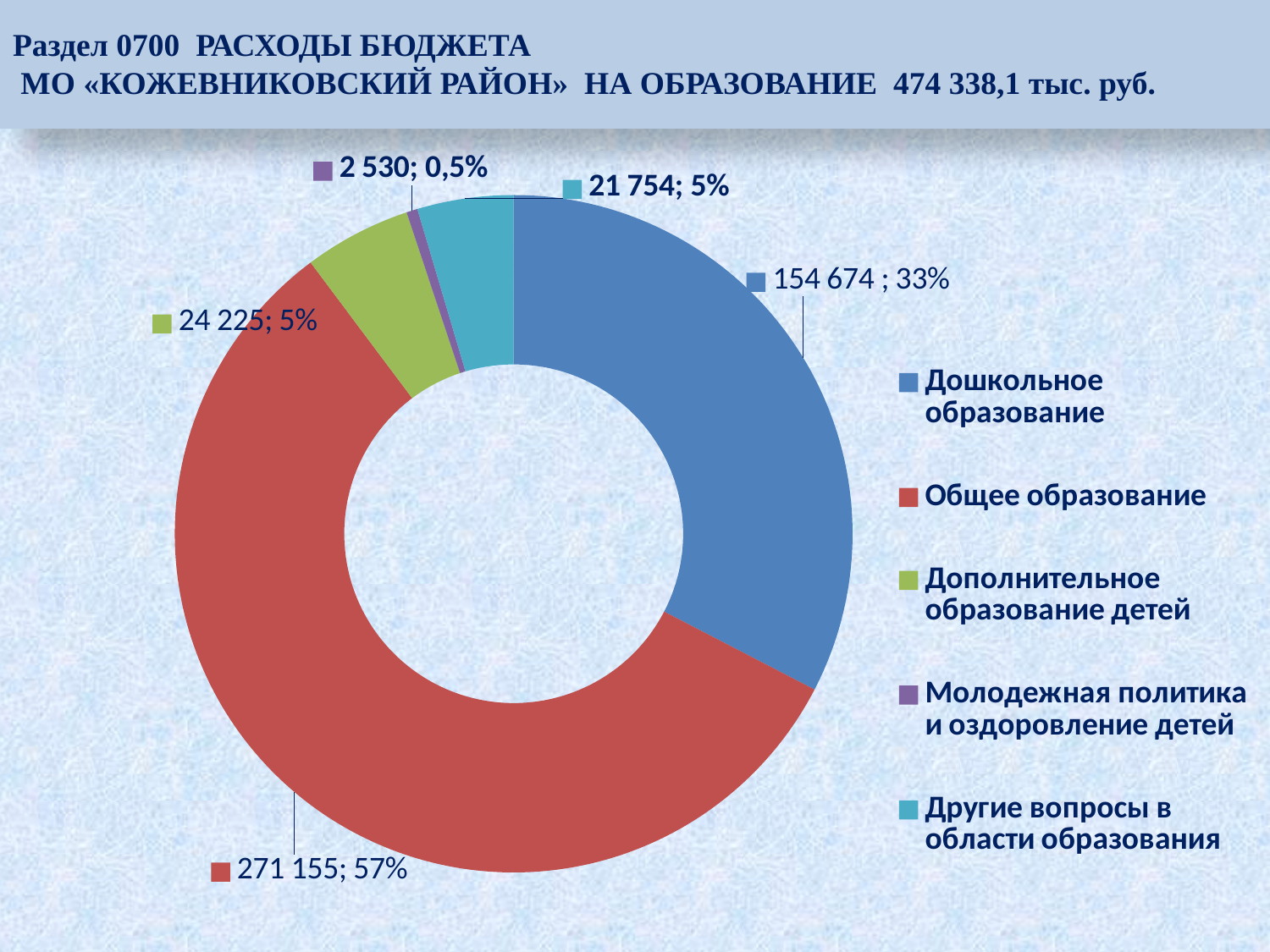
How many categories does the legend list? 5 What is the value for Общее образование? 271 155 What is the value for Другие вопросы в области образования? 21 754 What is the value for Дошкольное образование? 154 674 What kind of chart is shown on the slide? Doughnut (pie) chart What is the difference between the values for Общее образование and Дошкольное образование? 116 481 Which category has the smallest share of the chart? Молодежная политика и оздоровление детей Which category has the largest share of the chart? Общее образование What is the value for Молодежная политика и оздоровление детей? 2 530 What share of the chart does Дошкольное образование represent? 33% What share of the chart does Молодежная политика и оздоровление детей represent? 0,5% What is the value for Дополнительное образование детей? 24 225